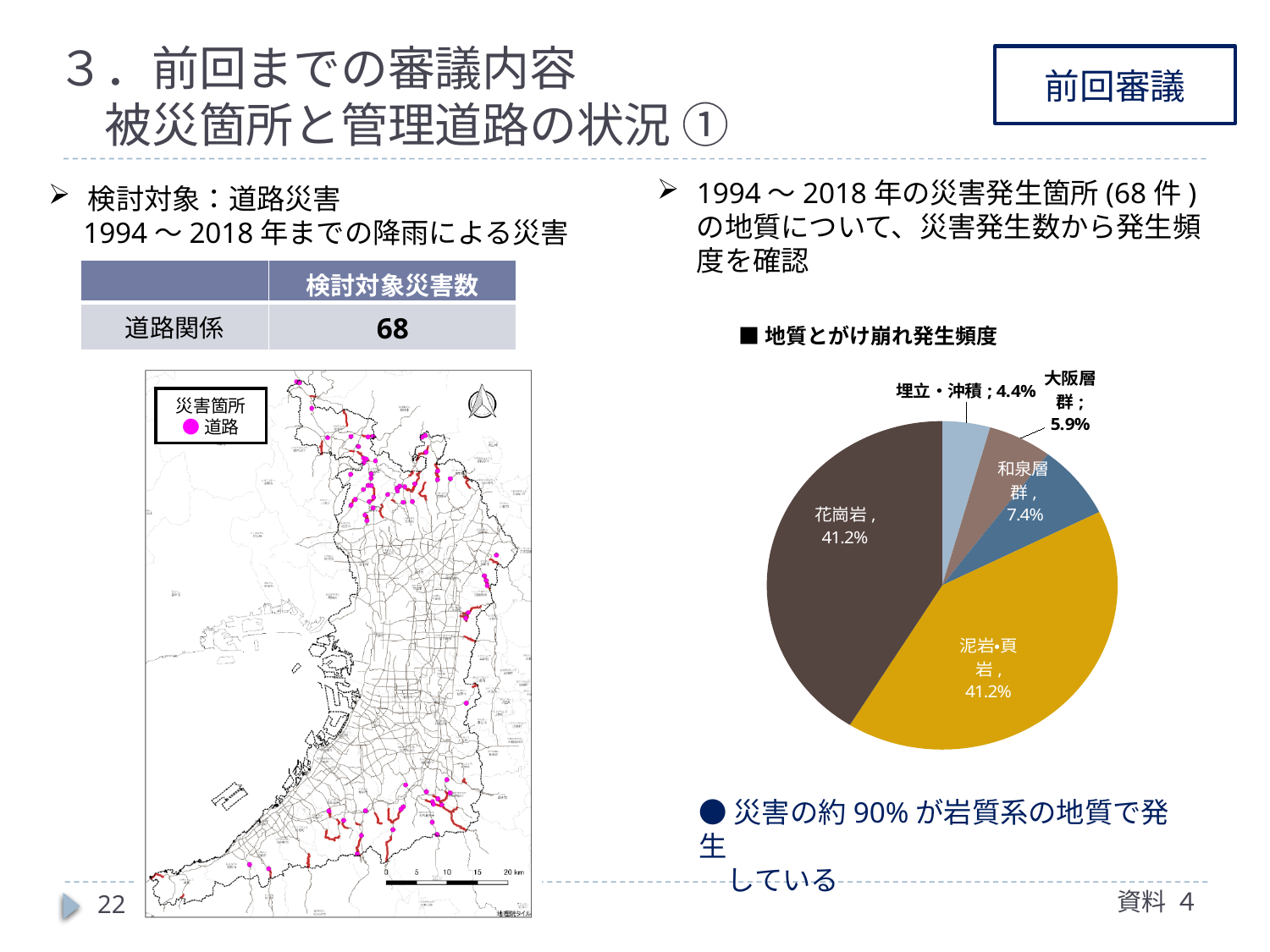
In the pie chart, what is the difference in percentage points between the share for 和泉層群 and the share for 大阪層群? 1.5 In the pie chart, what share is labelled for 大阪層群? 5.9% Which slice of the pie chart has the smallest share? 埋立・沖積 What kind of chart is shown under the heading 地質とがけ崩れ発生頻度? Pie chart In the pie chart, what share is labelled for 泥岩・頁岩? 41.2% In the pie chart, what share is labelled for 和泉層群? 7.4% How many slices does the pie chart have? 5 In the pie chart, what share is labelled for 花崗岩? 41.2% What is the title printed above the pie chart? 地質とがけ崩れ発生頻度 In the pie chart, what share is labelled for 埋立・沖積? 4.4% In the pie chart, what is the combined share of 花崗岩 and 泥岩・頁岩? 82.4% In the pie chart, which is larger: the share for 和泉層群 or the share for 大阪層群? 和泉層群